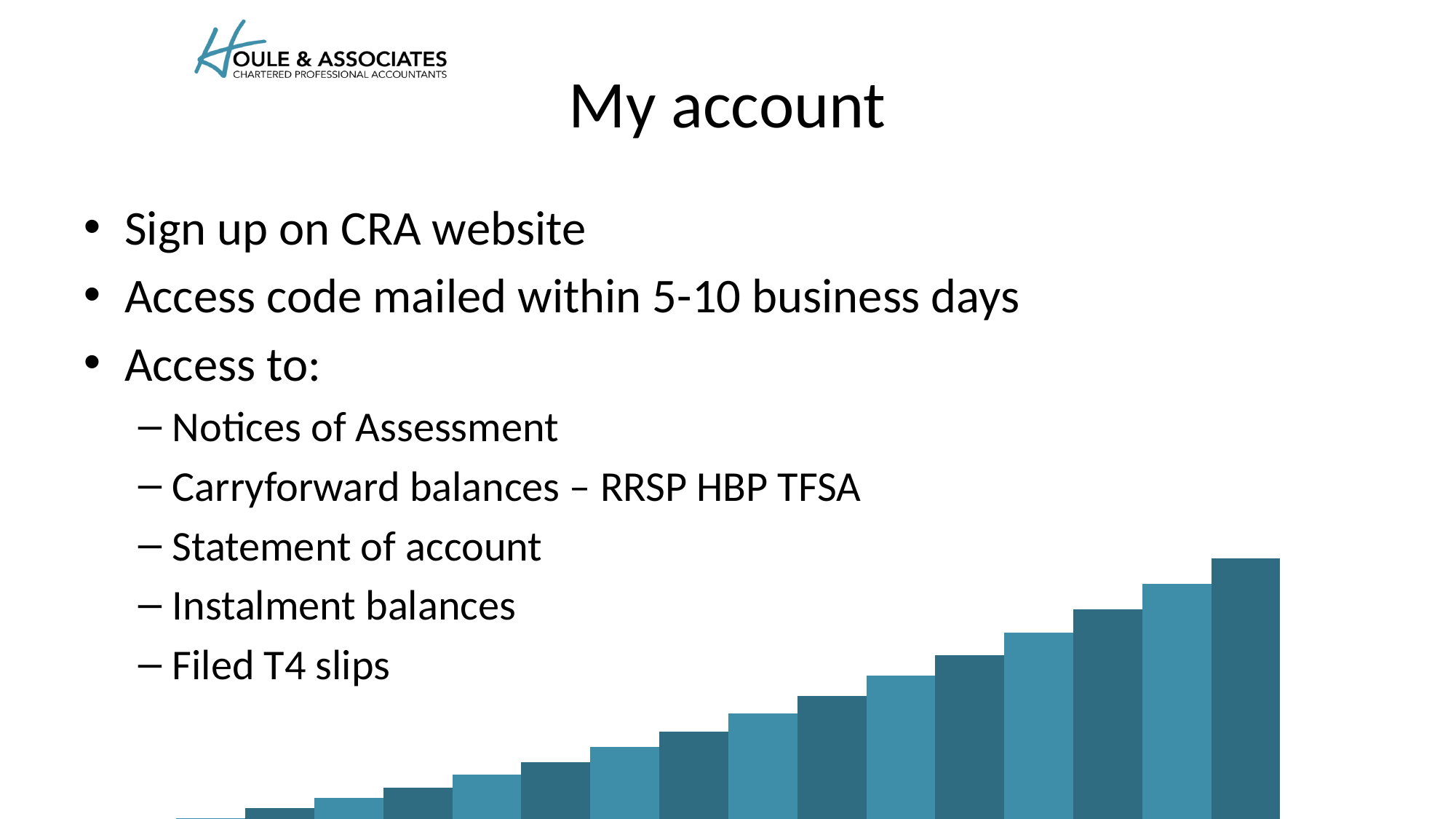
What kind of chart is shown at the bottom right of the slide? bar chart Which bar in the chart at the bottom of the slide is the tallest, the leftmost or the rightmost? rightmost Does the bar chart at the bottom of the slide show any axis labels or data labels? No Do the bars in the chart at the bottom of the slide rise or fall from left to right? rise